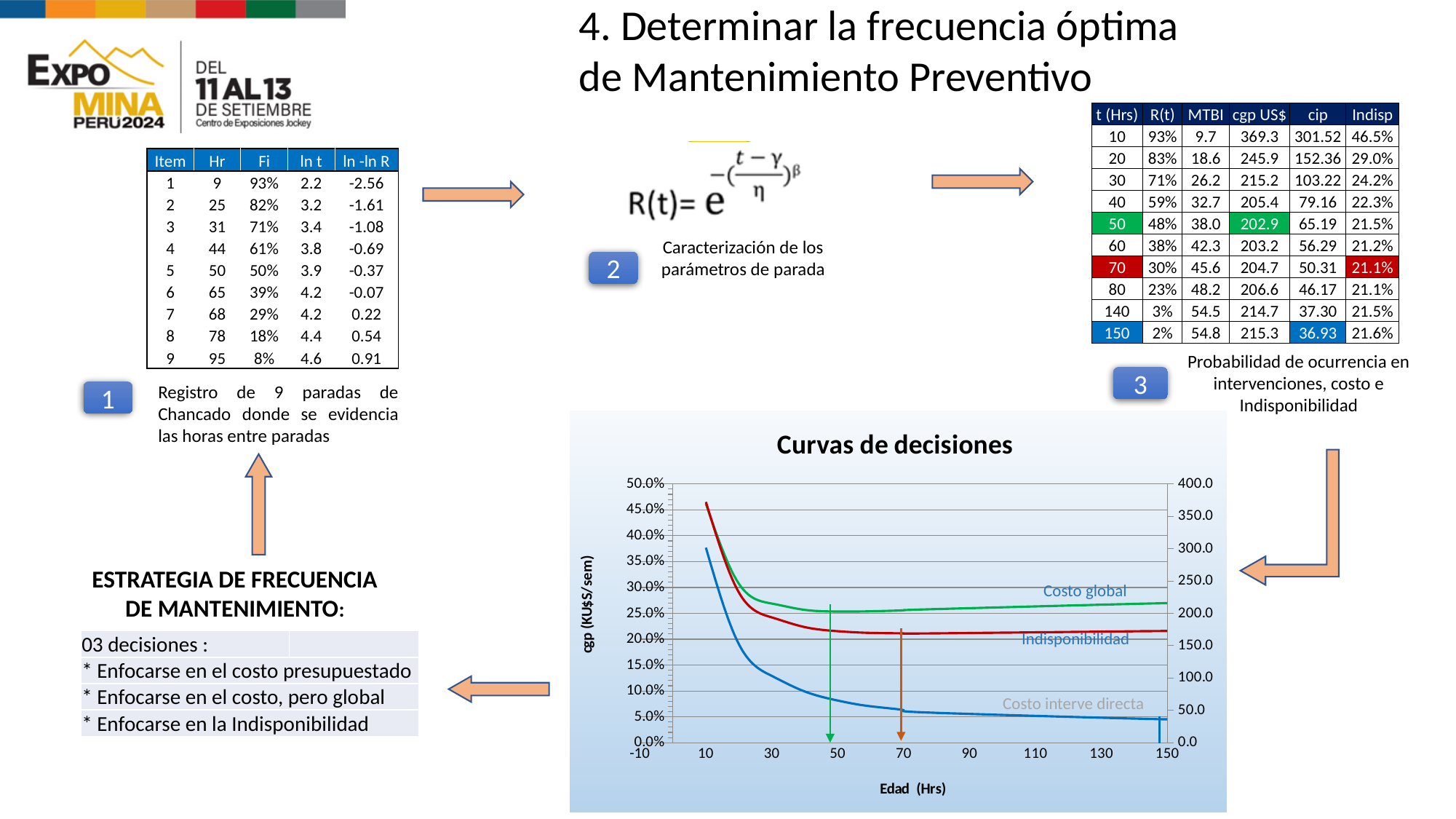
In the 'Curvas de decisiones' chart, which is higher at Edad 10: 'Indisponibilidad' or 'Costo interve directa'? Indisponibilidad What kind of chart is 'Curvas de decisiones'? line chart In the 'Curvas de decisiones' chart, is the 'Indisponibilidad' value at Edad 10 greater or less than 40.0% on the left axis? greater What is the maximum value shown on the left vertical axis of the 'Curvas de decisiones' chart? 50.0% What is the maximum value shown on the right vertical axis of the 'Curvas de decisiones' chart? 400.0 In the 'Curvas de decisiones' chart, does the 'Costo interve directa' curve rise or fall as Edad increases? fall How many series (curves) are plotted in the 'Curvas de decisiones' chart? 3 In the 'Curvas de decisiones' chart, is the 'Costo interve directa' value at Edad 150 greater or less than 10.0% on the left axis? less In the 'Curvas de decisiones' chart, which curve is the highest at Edad 150? Costo global What is the title of the chart on the slide? Curvas de decisiones What is the x-axis title of the 'Curvas de decisiones' chart? Edad (Hrs) In the 'Curvas de decisiones' chart, which curve is the lowest at Edad 150? Costo interve directa